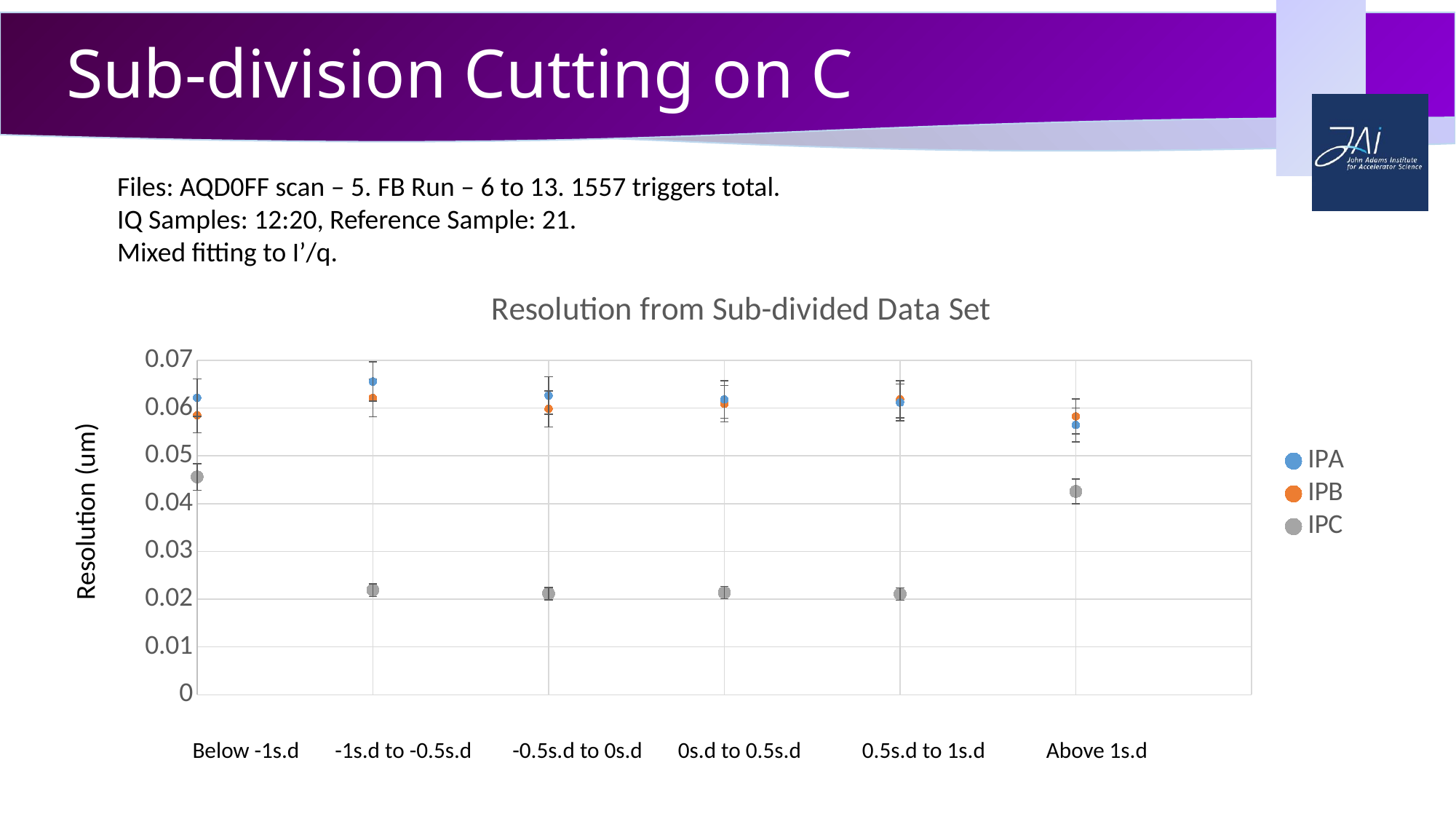
What is the title of the chart? Resolution from Sub-divided Data Set For which category is the IPC value highest? Below -1s.d Which is larger for 0s.d to 0.5s.d, the IPA value or the IPC value? IPA How many categories are shown along the x axis of the chart? 6 For which category is the IPA value highest? -1s.d to -0.5s.d What is the label of the y axis of the chart? Resolution (um) Is the IPC value for -0.5s.d to 0s.d greater or less than 0.03? less For which category is the IPA value lowest? Above 1s.d What kind of chart is shown on the slide? Scatter chart How many series does the chart legend list? 3 Is the IPC value for Below -1s.d greater or less than 0.04? greater Is the IPA value for -1s.d to -0.5s.d greater or less than 0.06? greater